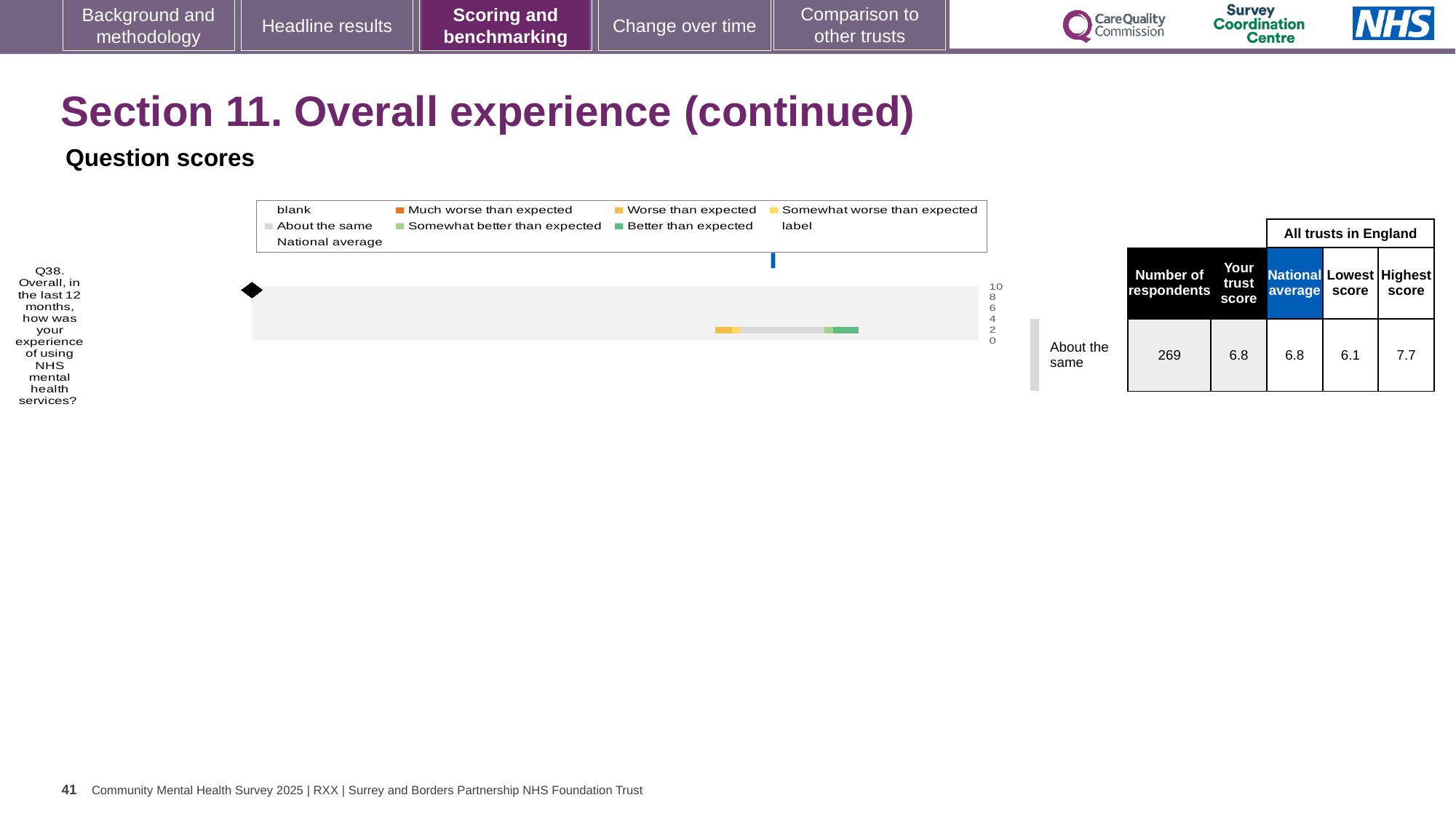
What is the trust's score for Q38 (Overall, in the last 12 months, how was your experience of using NHS mental health services?)? 6.8 What colour represents 'Much worse than expected' in the chart legend? Orange What is the national average score for Q38? 6.8 Is the trust's score for Q38 greater or less than 4 on the chart's axis? greater What is the lowest score among all trusts in England for Q38? 6.1 How many respondents answered Q38? 269 What is the difference between the trust's score and the lowest score for Q38? 0.7 How many survey questions are plotted in the chart? 1 What kind of chart is used to show the Q38 question score? Bar chart Which benchmarking category is the trust's Q38 result placed in? About the same What is the difference between the highest and lowest trust scores for Q38? 1.6 What is the highest score among all trusts in England for Q38? 7.7